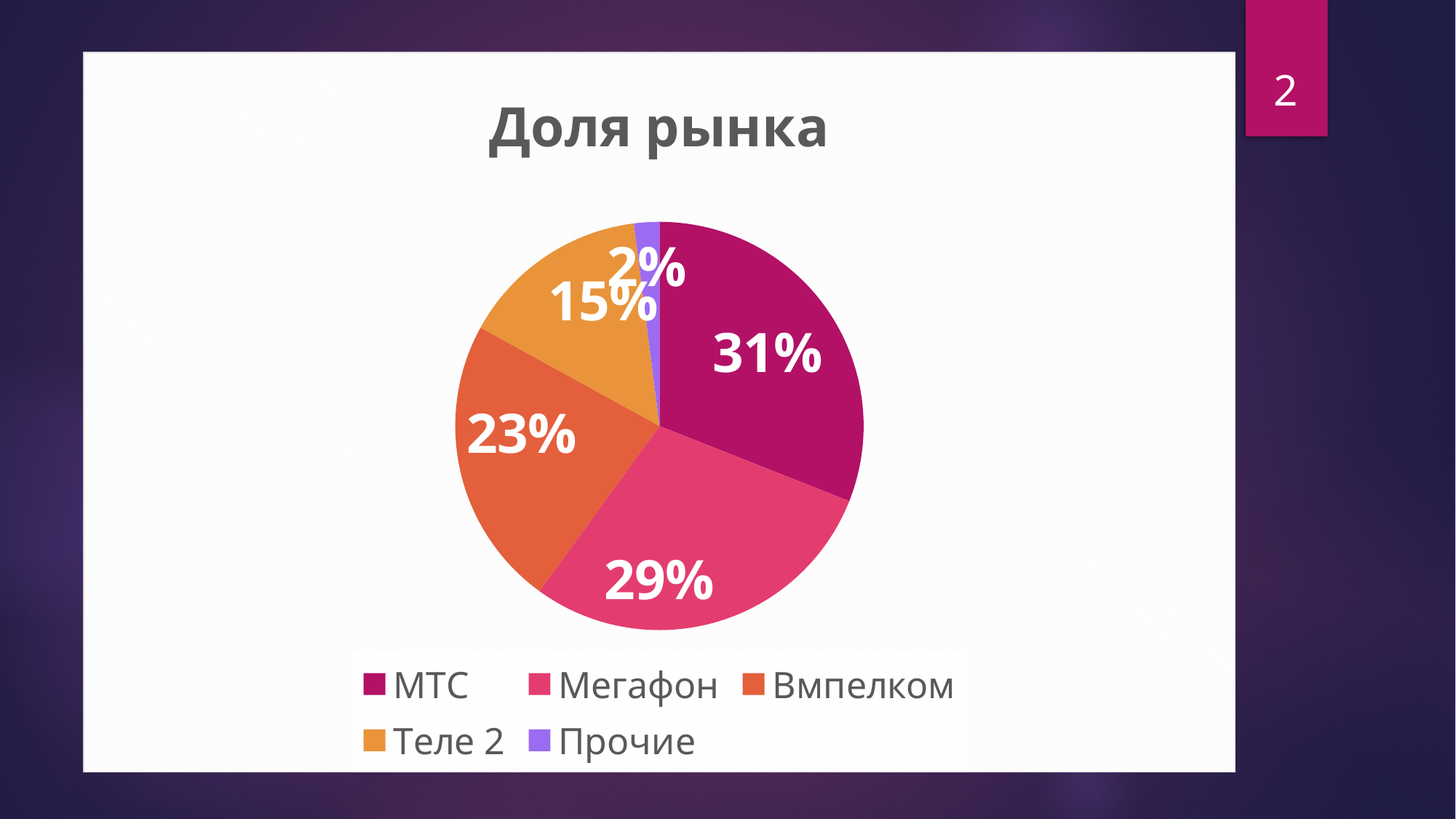
Which category has the smallest slice of the pie? Прочие What is the market share shown for Прочие? 2% What is the market share shown for Вмпелком? 23% What is the market share shown for Теле 2? 15% Which has a larger share, Вмпелком or Мегафон? Мегафон What is the market share shown for Мегафон? 29% How many categories does the pie chart show? 5 What is the difference in percentage points between МТС and Теле 2? 16 Which category has the largest slice of the pie? МТС What is the title of the chart? Доля рынка What kind of chart is shown on the slide? Pie chart What is the market share shown for МТС? 31%